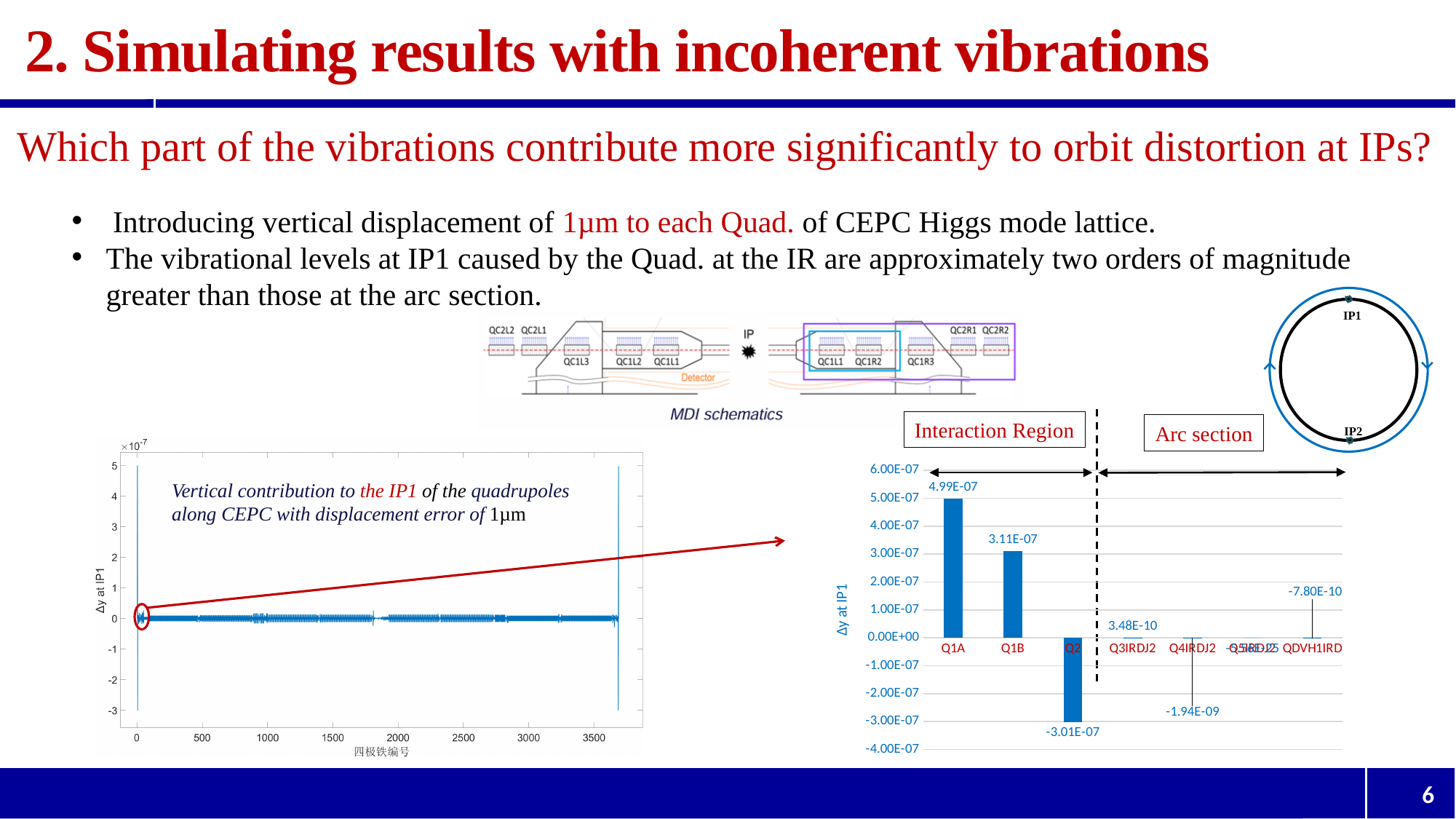
In the bar chart on the right, which category has the lowest value? Q2 In the bar chart on the right, what is the value for Q4IRDJ2? -1.94E-09 In the bar chart on the right, what is the value for Q1B? 3.11E-07 In the bar chart on the right, what is the value for Q2? -3.01E-07 In the bar chart on the right, which category has the highest value? Q1A In the bar chart on the right, what is the value for Q1A? 4.99E-07 In the bar chart on the right, what is the difference between the values for Q1A and Q1B? 1.88E-07 In the bar chart on the right, what is the value for Q3IRDJ2? 3.48E-10 In the bar chart on the right, what is the value for QDVH1IRD? -7.80E-10 In the bar chart on the right, which is larger, the value for Q1A or the value for Q1B? Q1A In the bar chart on the right, what is the label of the vertical axis? Δy at IP1 What kind of chart is the chart on the right of the slide? Bar chart